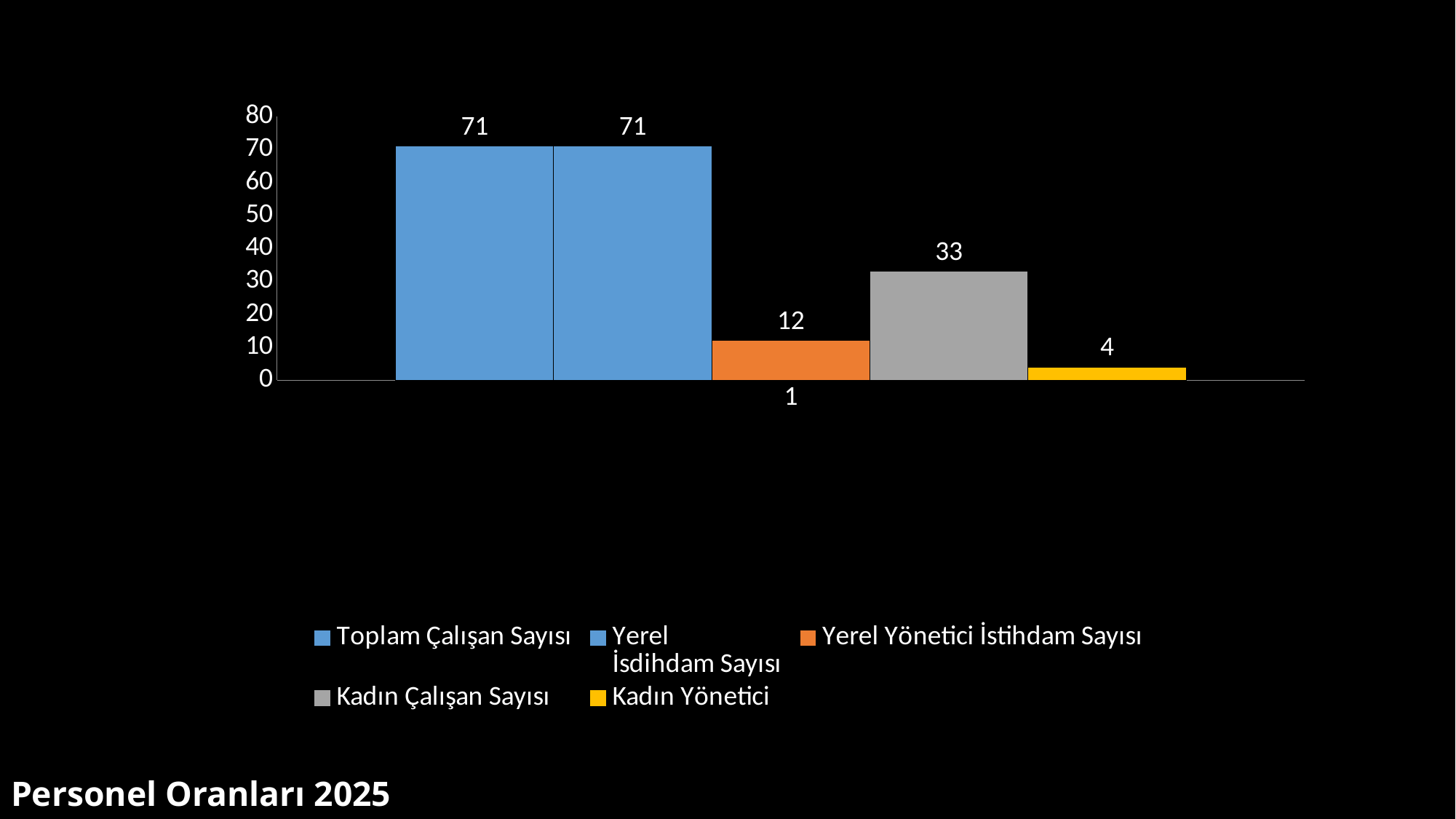
What is the value for Toplam Çalışan Sayısı? 71 Which series has the lowest value? Kadın Yönetici What is the value for Yerel Yönetici İstihdam Sayısı? 12 What colour is the bar for Kadın Yönetici? Yellow What is the difference between Kadın Çalışan Sayısı and Kadın Yönetici? 29 What is the value for Kadın Yönetici? 4 What kind of chart is shown on the slide? Bar chart What is the difference between Toplam Çalışan Sayısı and Kadın Çalışan Sayısı? 38 Which is larger, Yerel Yönetici İstihdam Sayısı or Kadın Çalışan Sayısı? Kadın Çalışan Sayısı How many series does the legend list? 5 What is the value for Kadın Çalışan Sayısı? 33 Is the value for Kadın Çalışan Sayısı greater or less than 30? greater